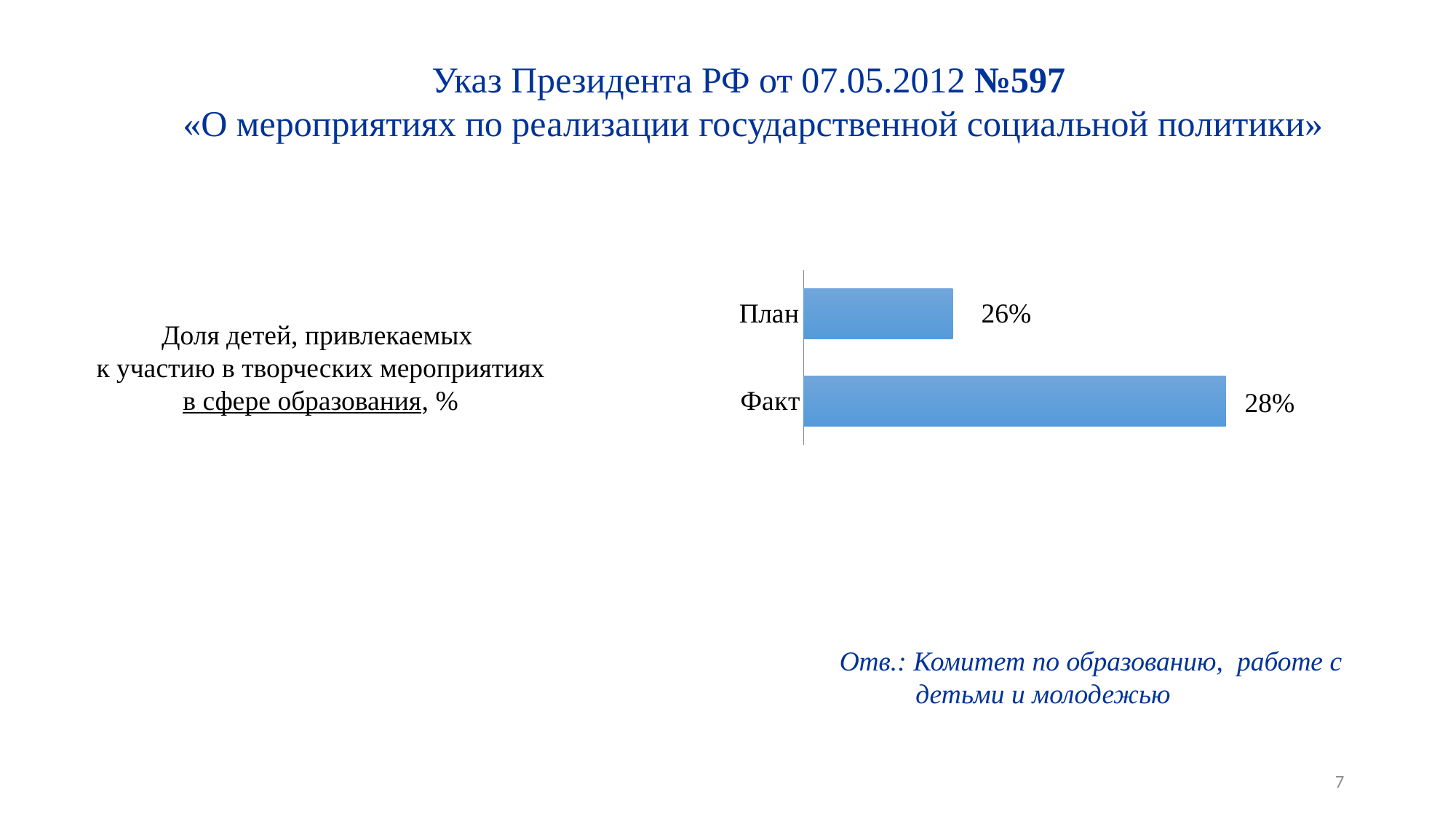
Is the value for Факт larger or smaller than the value for План? larger What colour are the bars in the chart? blue What indicator does the chart describe, according to the text to its left? Доля детей, привлекаемых к участию в творческих мероприятиях в сфере образования, % Which category has the higher value, План or Факт? Факт How many categories are shown in the chart? 2 What kind of chart is shown on the slide? bar chart Which category has the lower value? План What is the difference between the Факт and План values? 2% What is the value for Факт (Fact)? 28% What is the value for План (Plan)? 26%